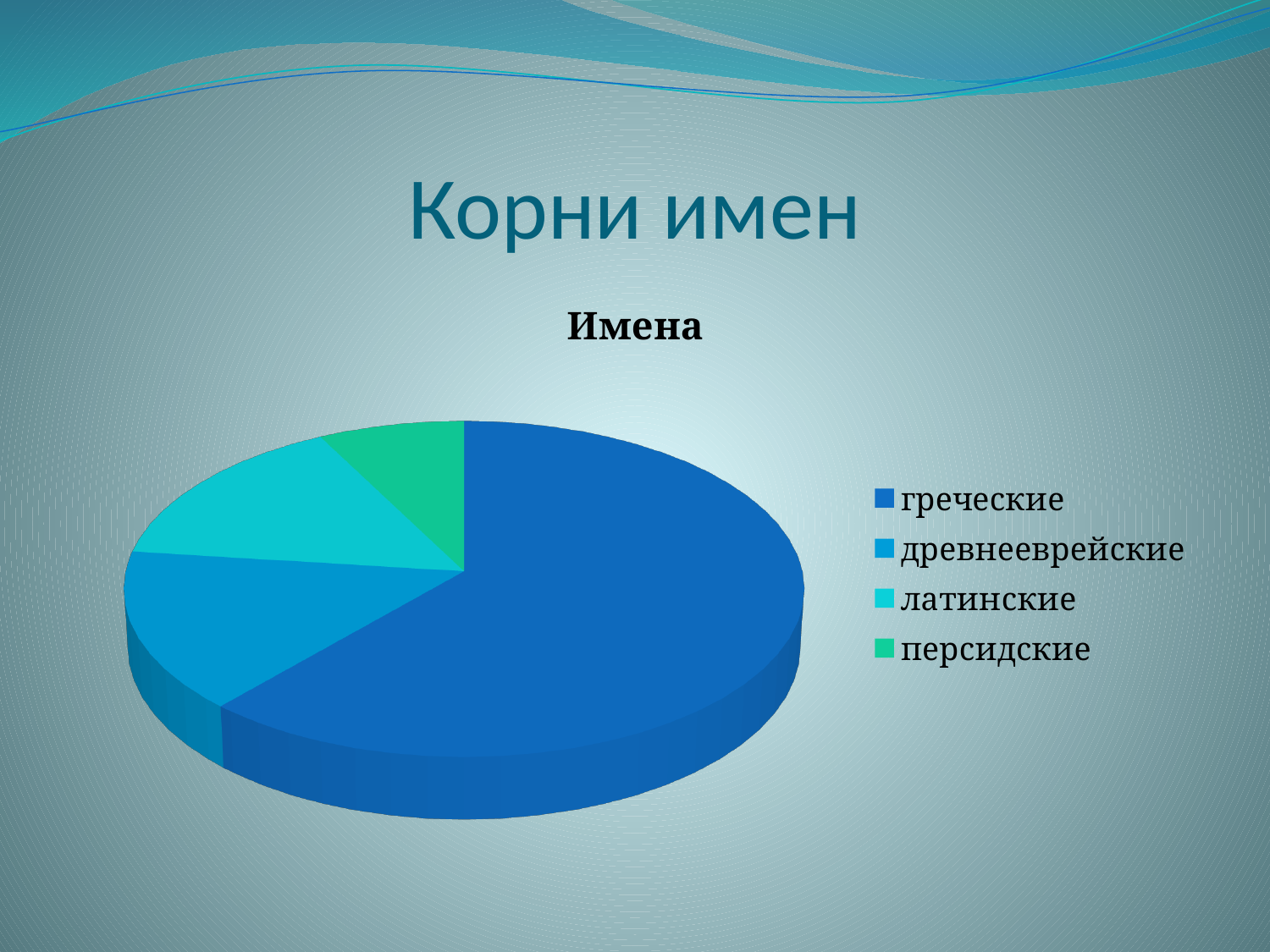
Which category is listed last in the legend? персидские Which slice is larger, латинские or персидские? латинские Which category has the largest slice of the pie? греческие What kind of chart is shown on the slide? pie chart Which category has the smallest slice of the pie? персидские What is the title of the chart? Имена Which slice is larger, греческие or древнееврейские? греческие Does the греческие slice take up more or less than half of the pie? more How many categories does the pie chart have? 4